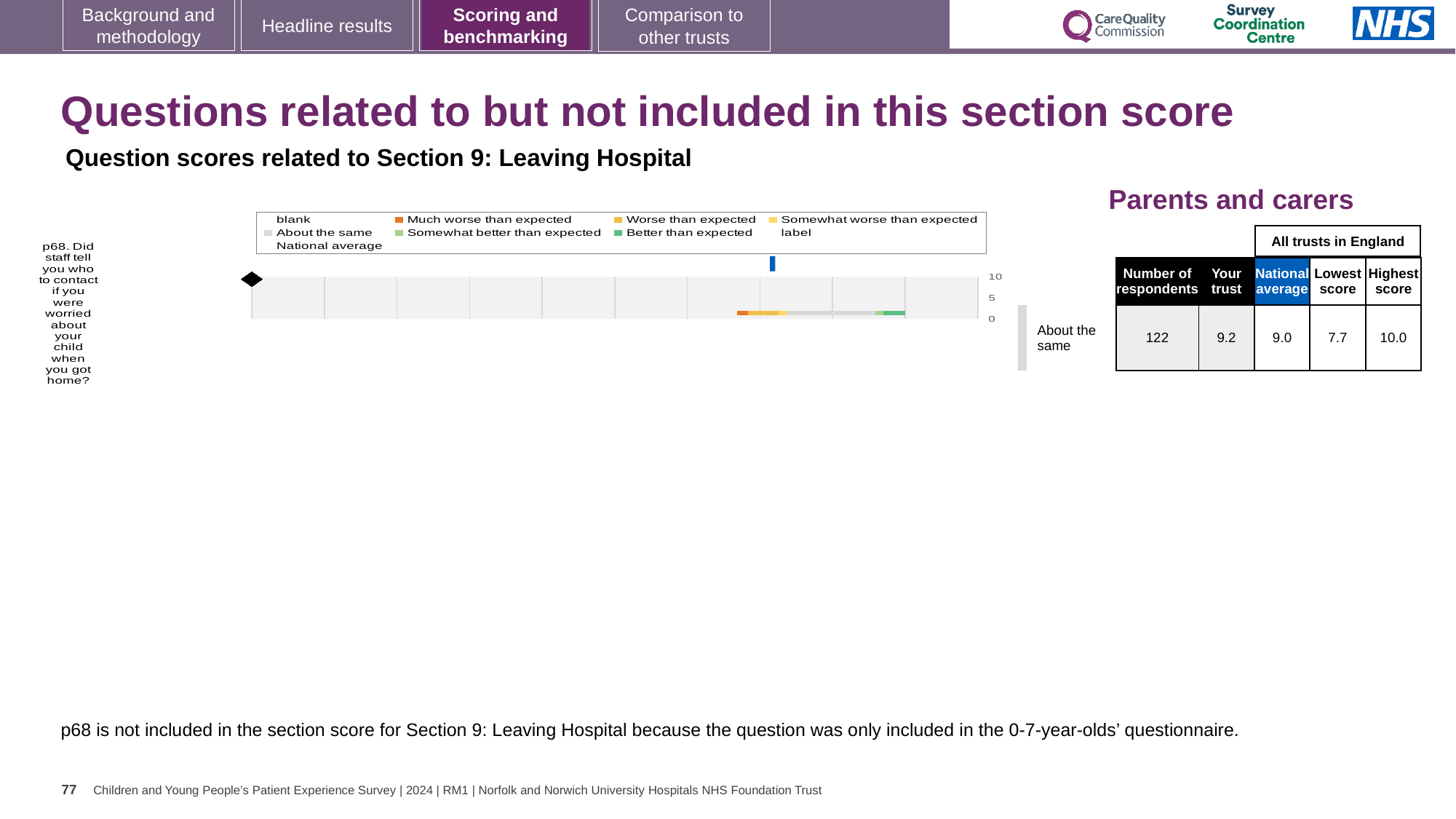
In the table next to the chart, how many respondents answered p68? 122 What is the difference between the 'Your trust' score and the national average for p68? 0.2 What is the difference between the highest score and the lowest score for p68 in the table? 2.3 Which legend entry is shown in orange? Much worse than expected Which is larger for p68, the 'Your trust' score or the national average? Your trust In the table next to the chart, what is the 'Your trust' score for p68? 9.2 In the table next to the chart, what is the lowest score among all trusts in England for p68? 7.7 How many questions are plotted on the chart? 1 What is the highest value shown on the chart's vertical axis? 10 What kind of chart is used to show the p68 question score? bar chart In the table next to the chart, what is the national average score for p68? 9.0 In the table next to the chart, what is the highest score among all trusts in England for p68? 10.0